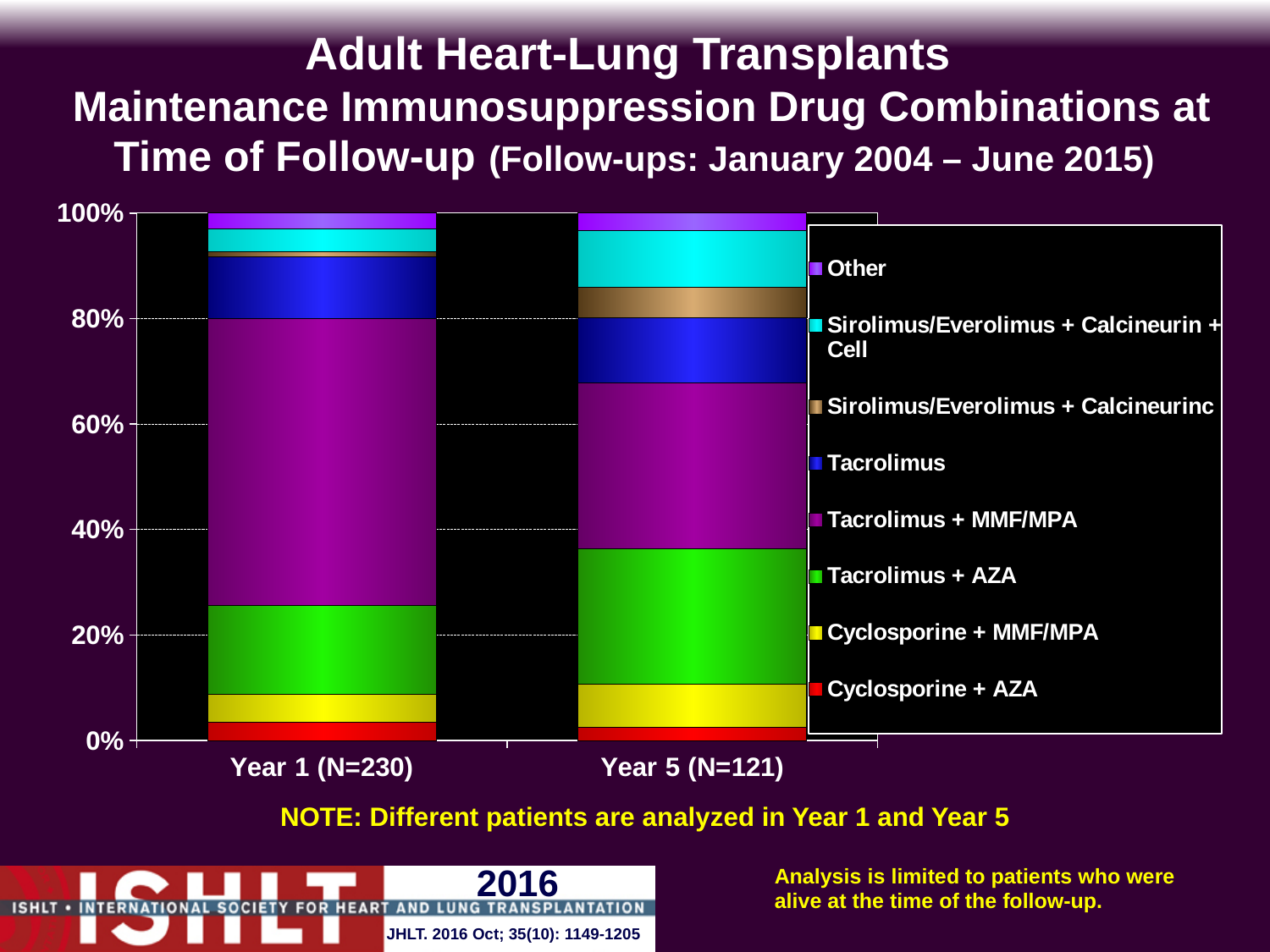
How many categories (bars) are shown on the x axis? 2 How many series does the legend list? 8 What kind of chart is shown on the slide? Stacked bar chart Which year has the larger share of Tacrolimus + AZA, Year 1 (N=230) or Year 5 (N=121)? Year 5 (N=121) What are the two category labels on the x axis? Year 1 (N=230) and Year 5 (N=121) Which drug combination makes up the largest segment of the Year 5 (N=121) bar? Tacrolimus + MMF/MPA Does the share of Tacrolimus + MMF/MPA rise or fall from Year 1 to Year 5? fall Is the share of Tacrolimus + AZA in Year 5 (N=121) greater or less than 20%? greater Is the share of Tacrolimus + MMF/MPA in Year 1 (N=230) greater or less than 40%? greater Is the share of Tacrolimus + MMF/MPA in Year 5 (N=121) greater or less than 40%? less Which legend entry is shown in red? Cyclosporine + AZA Which drug combination makes up the largest segment of the Year 1 (N=230) bar? Tacrolimus + MMF/MPA